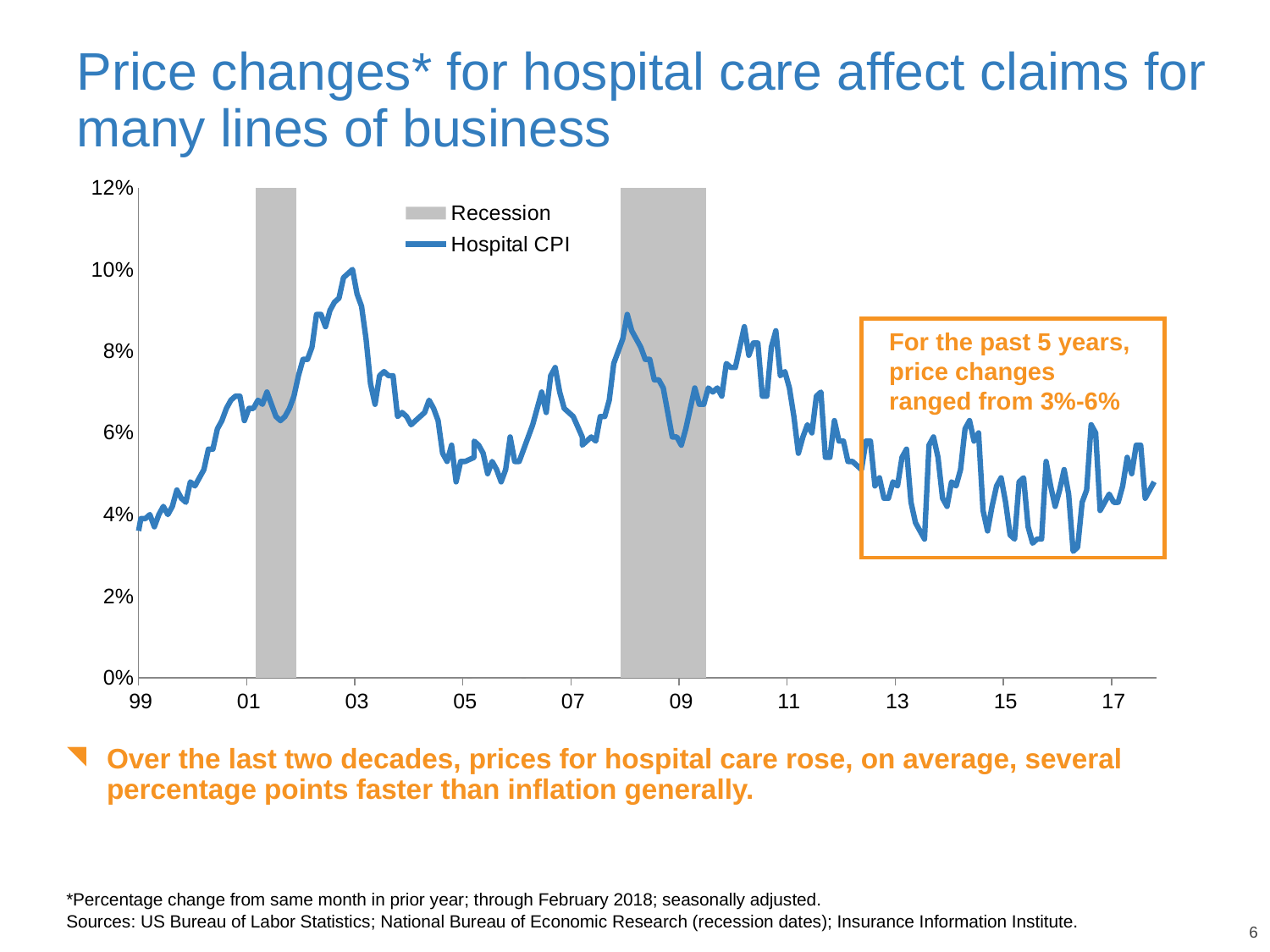
Does the Hospital CPI rise or fall between its peak around 2003 and 2005? fall Is the peak value of Hospital CPI around 2003 greater or less than 8%? greater Is the Hospital CPI value around 2005 greater or less than 6%? less According to the annotation box on the chart, what range did price changes fall within over the past 5 years? 3%-6% Is the Hospital CPI value at the start of the series in 1999 greater or less than 6%? less Does the Hospital CPI rise or fall between 1999 and its peak around 2003? rise What kind of chart is shown on the slide? Line chart How many entries does the chart legend list? 2 How many recession periods are shaded on the chart? 2 What is the highest value shown on the vertical axis of the chart? 12% What are the two entries in the chart legend? Recession and Hospital CPI